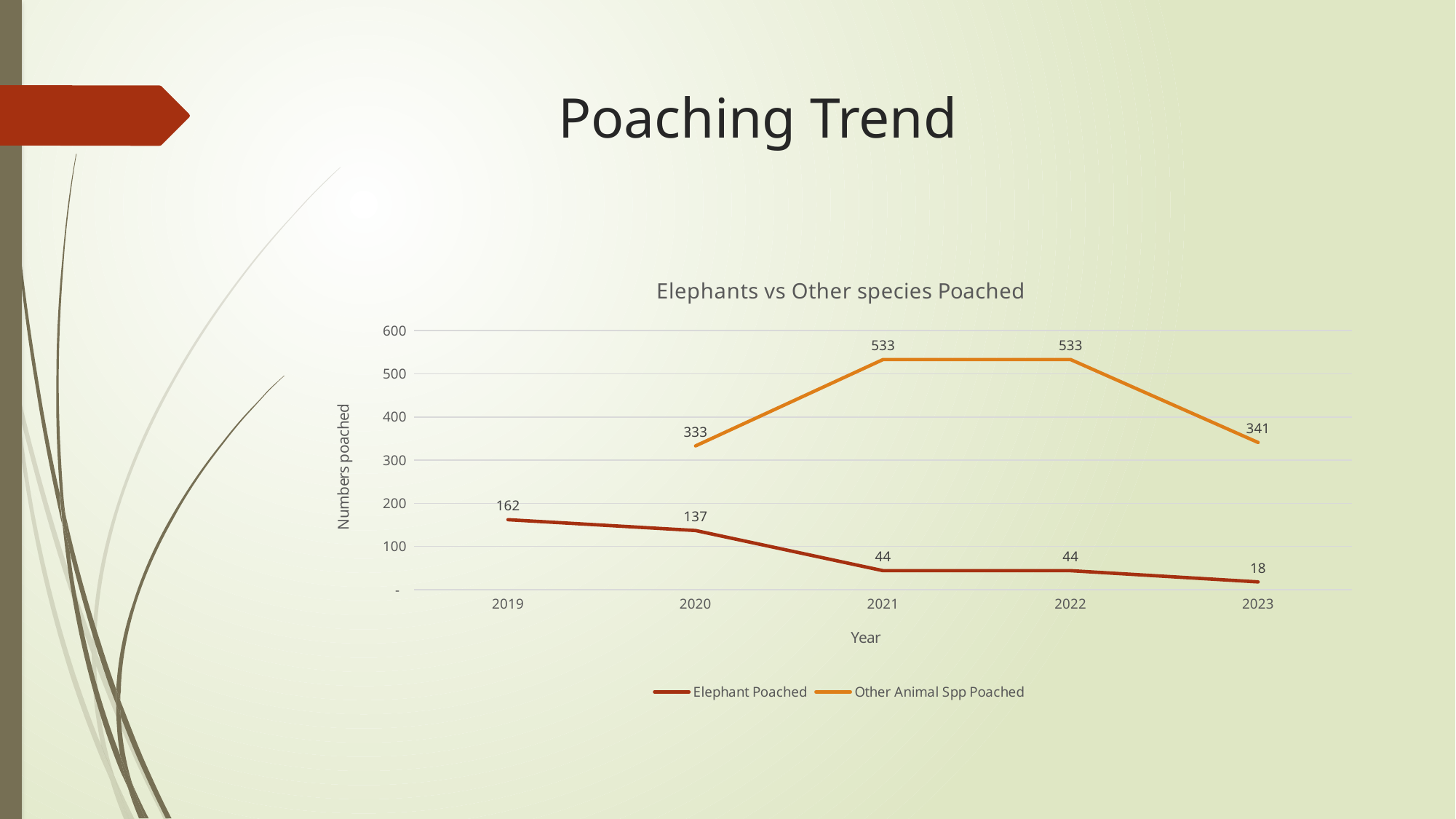
Does the number of elephants poached rise or fall from 2019 to 2023? Fall How many years are shown on the x axis? 5 How many series does the legend list? 2 What is the highest value for Other Animal Spp Poached? 533 What is the difference between elephants poached in 2019 and 2020? 25 In which year was the number of elephants poached lowest? 2023 What is the value for Other Animal Spp Poached in 2023? 341 Which is larger in 2021: Elephant Poached or Other Animal Spp Poached? Other Animal Spp Poached What is the difference between Other Animal Spp Poached in 2022 and 2023? 192 What type of chart is shown on the slide? Line chart How many elephants were poached in 2019? 162 What is the title of the chart? Elephants vs Other species Poached